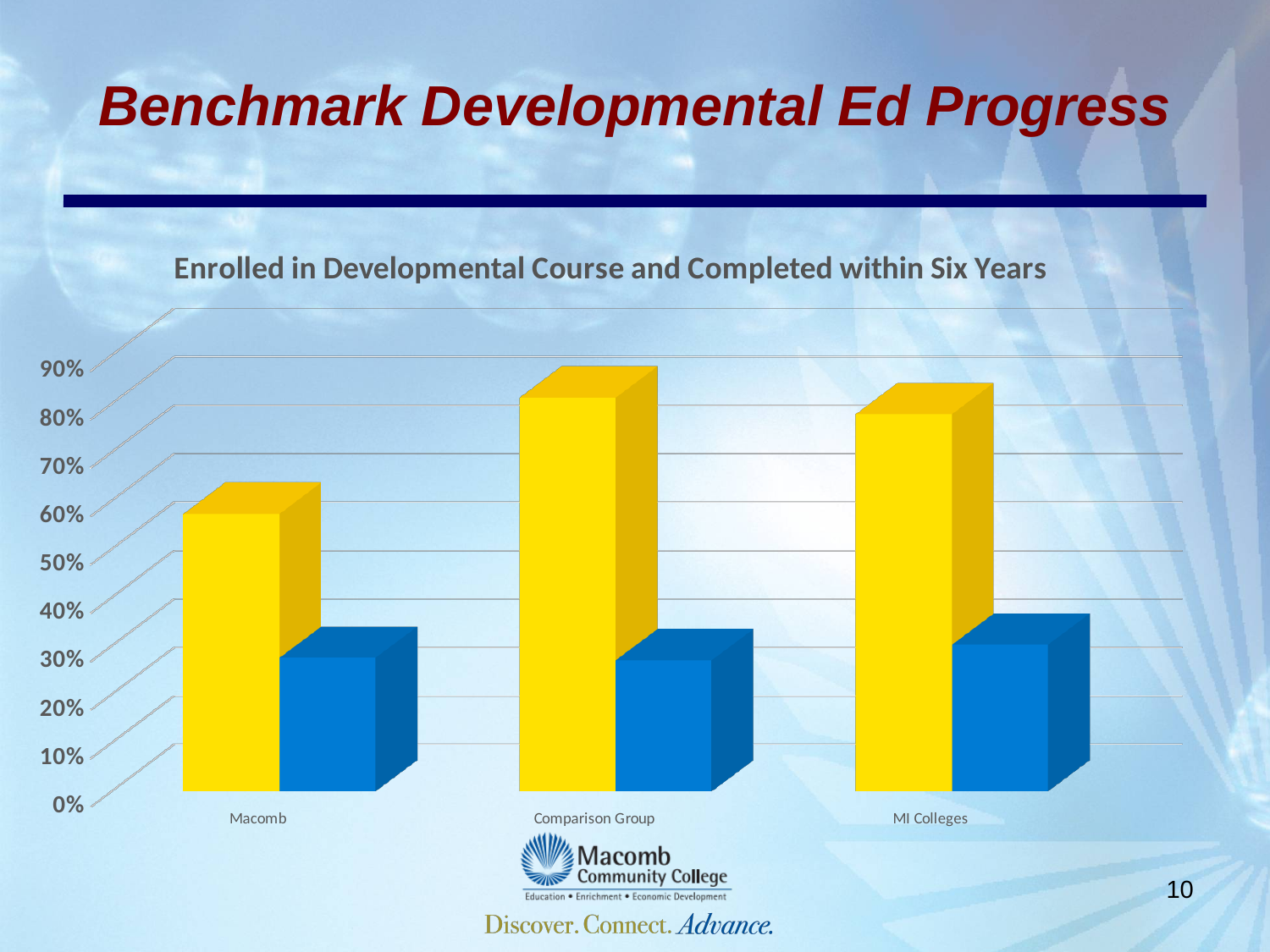
Which is larger, the yellow bar for Macomb or the yellow bar for Comparison Group? Comparison Group Is the yellow bar for Comparison Group greater or less than 70%? greater What kind of chart is shown on the slide? Bar chart Is the yellow bar for MI Colleges greater or less than 70%? greater Is the blue bar for MI Colleges greater or less than 20%? greater How many categories are shown on the x axis of the chart? 3 Which category has the tallest yellow bar? Comparison Group What is the title of the chart? Enrolled in Developmental Course and Completed within Six Years Which category has the shortest yellow bar? Macomb For Macomb, which bar is taller, the yellow bar or the blue bar? The yellow bar